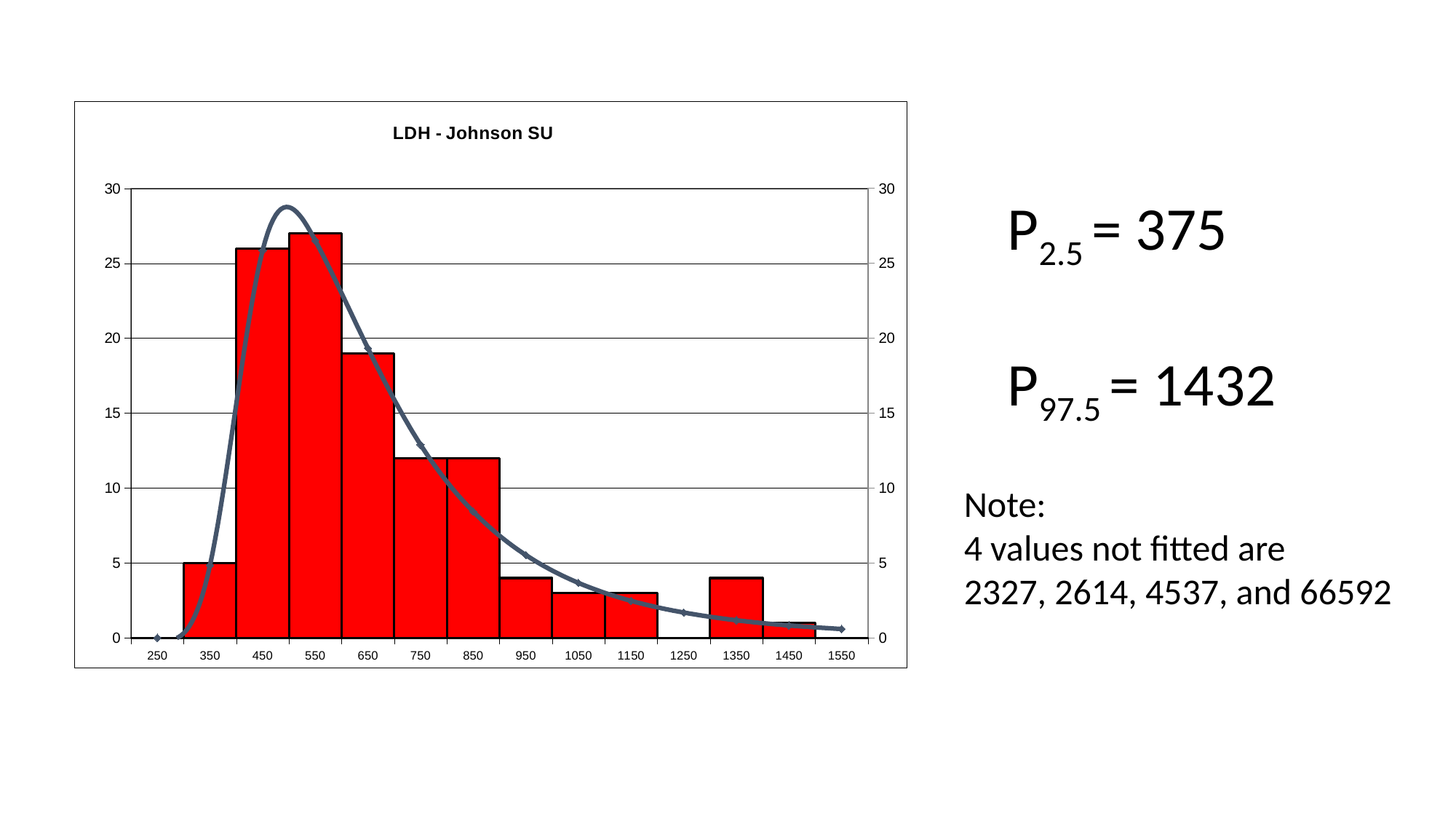
Is the bar for the 1350 bin greater or less than 5? less Is the bar for the 650 bin greater or less than 20? less Is the bar for the 450 bin greater or less than 25? greater Which x-axis bin has the shortest visible bar? 1450 Do the bar heights rise or fall moving from the 550 bin to the 1150 bin? fall Which bar is taller, the one for the 650 bin or the one for the 750 bin? 650 What is the bar height for the 350 bin? 5 How many x-axis tick labels are shown on the chart? 14 What kind of chart is shown on the slide? Bar chart (histogram) with a fitted curve What is the title of the chart? LDH - Johnson SU Which x-axis bin has the tallest bar? 550